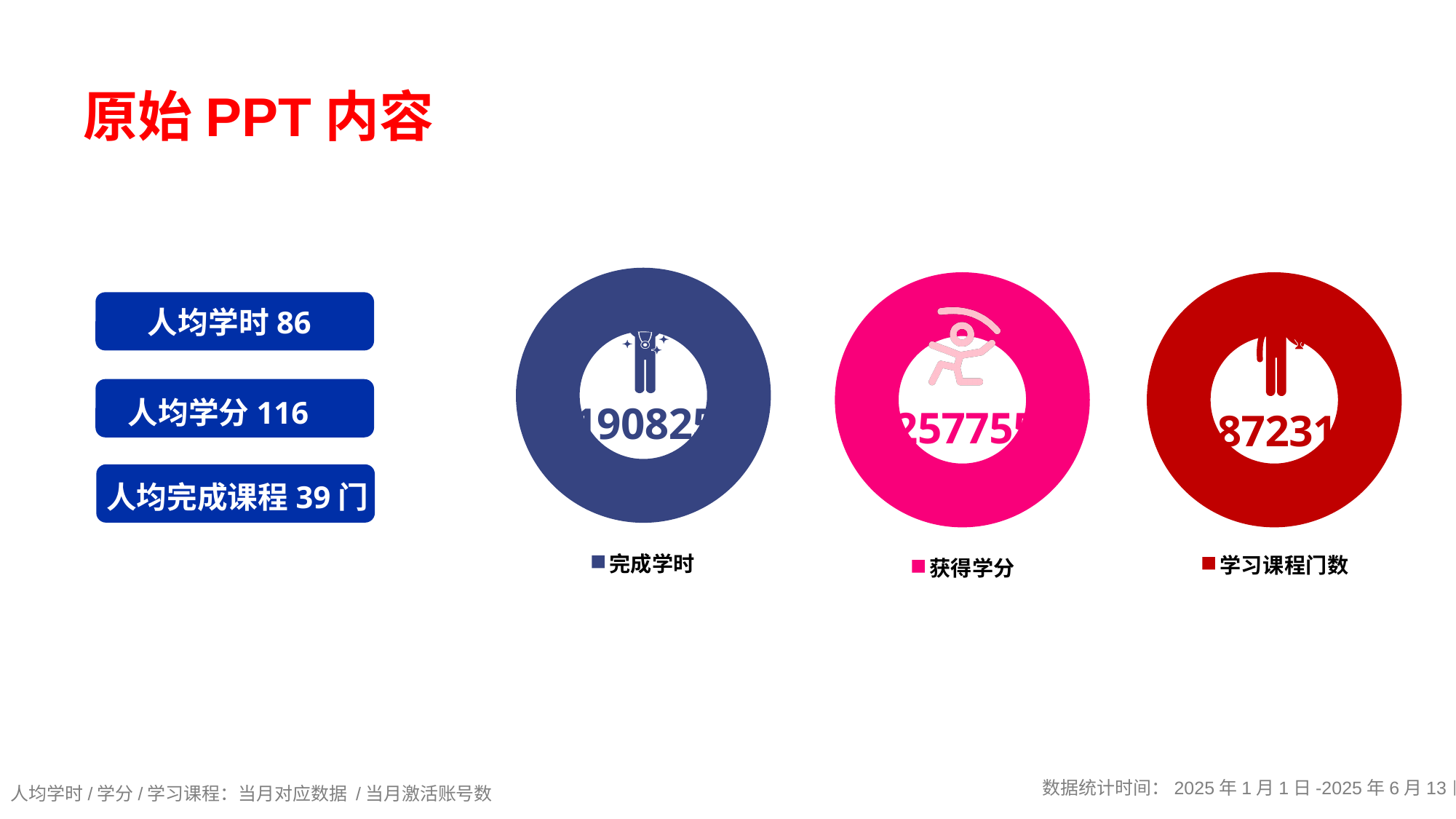
What is the legend label under the left (dark blue) doughnut chart? 完成学时 What is the legend label under the middle (pink) doughnut chart? 获得学分 Which is larger, the value in the 完成学时 chart or the value in the 学习课程门数 chart? 完成学时 What value is printed in the centre of the 学习课程门数 doughnut chart? 87231 Which of the three doughnut charts shows the lowest value? 学习课程门数 What value is printed in the centre of the 获得学分 doughnut chart? 257755 How many doughnut charts are shown on the slide? 3 Which of the three doughnut charts shows the highest value? 获得学分 What is the difference between the value in the 获得学分 chart and the value in the 完成学时 chart? 66930 What kind of chart is used for the three circular graphics in the middle of the slide? Doughnut chart What value is printed in the centre of the 完成学时 doughnut chart? 190825 What is the difference between the value in the 完成学时 chart and the value in the 学习课程门数 chart? 103594